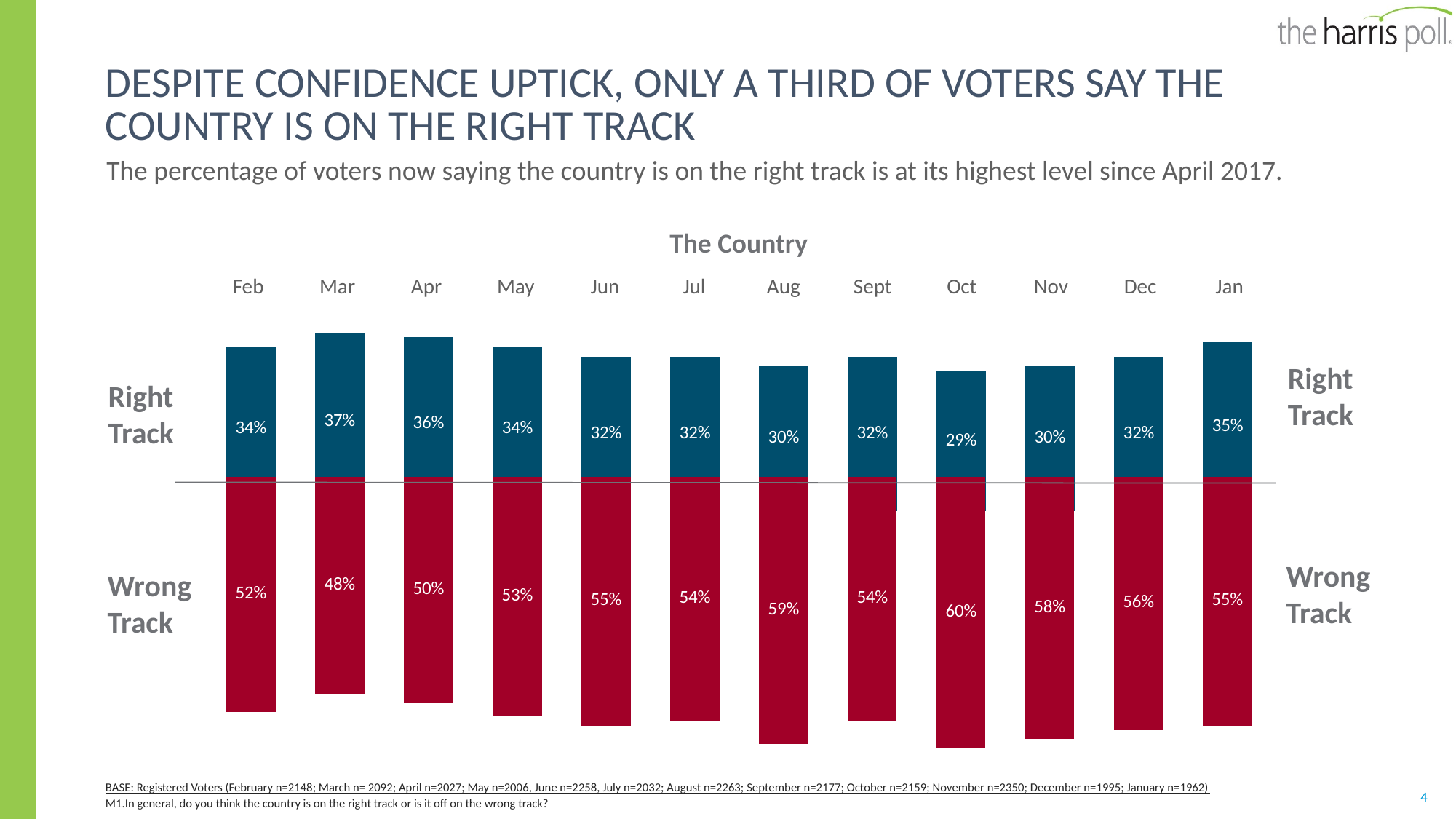
In which month is the Wrong Track percentage lowest? Mar What percentage of voters said the country was on the right track in March? 37% What is the Right Track value for January? 35% Which is larger, the Right Track value in April or the Right Track value in August? April How many months are shown on the chart? 12 In which month is the Right Track percentage lowest? Oct What is the title of the chart? The Country In which month is the Right Track percentage highest? Mar What is the Wrong Track value for October? 60% What colour are the Wrong Track bars? Red What is the difference between the Wrong Track and Right Track values in October? 31 percentage points What kind of chart is shown on the slide? Bar chart